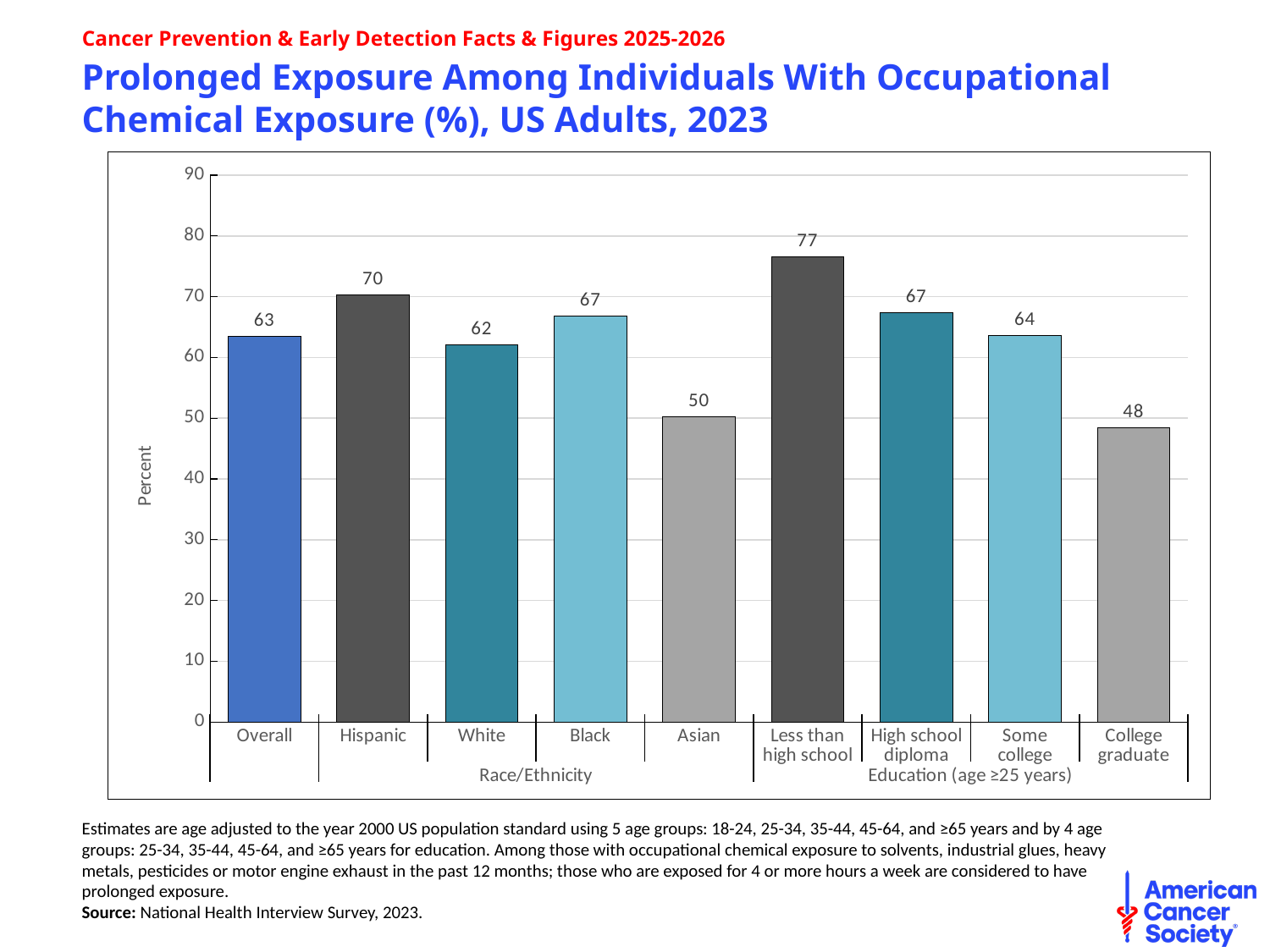
Which category has the highest value? Less than high school Is the value for Asian greater or less than 60? less What is the value for Hispanic? 70 How many bars are shown in the chart? 9 What is the difference between the values for Less than high school and College graduate? 29 Which category has the lowest value? College graduate Which is larger, the value for Black or the value for White? Black What kind of chart is shown on the slide? Bar chart What is the difference between the values for Hispanic and Asian? 20 What is the value for Less than high school? 77 What is the value for College graduate? 48 What is the value for Overall? 63